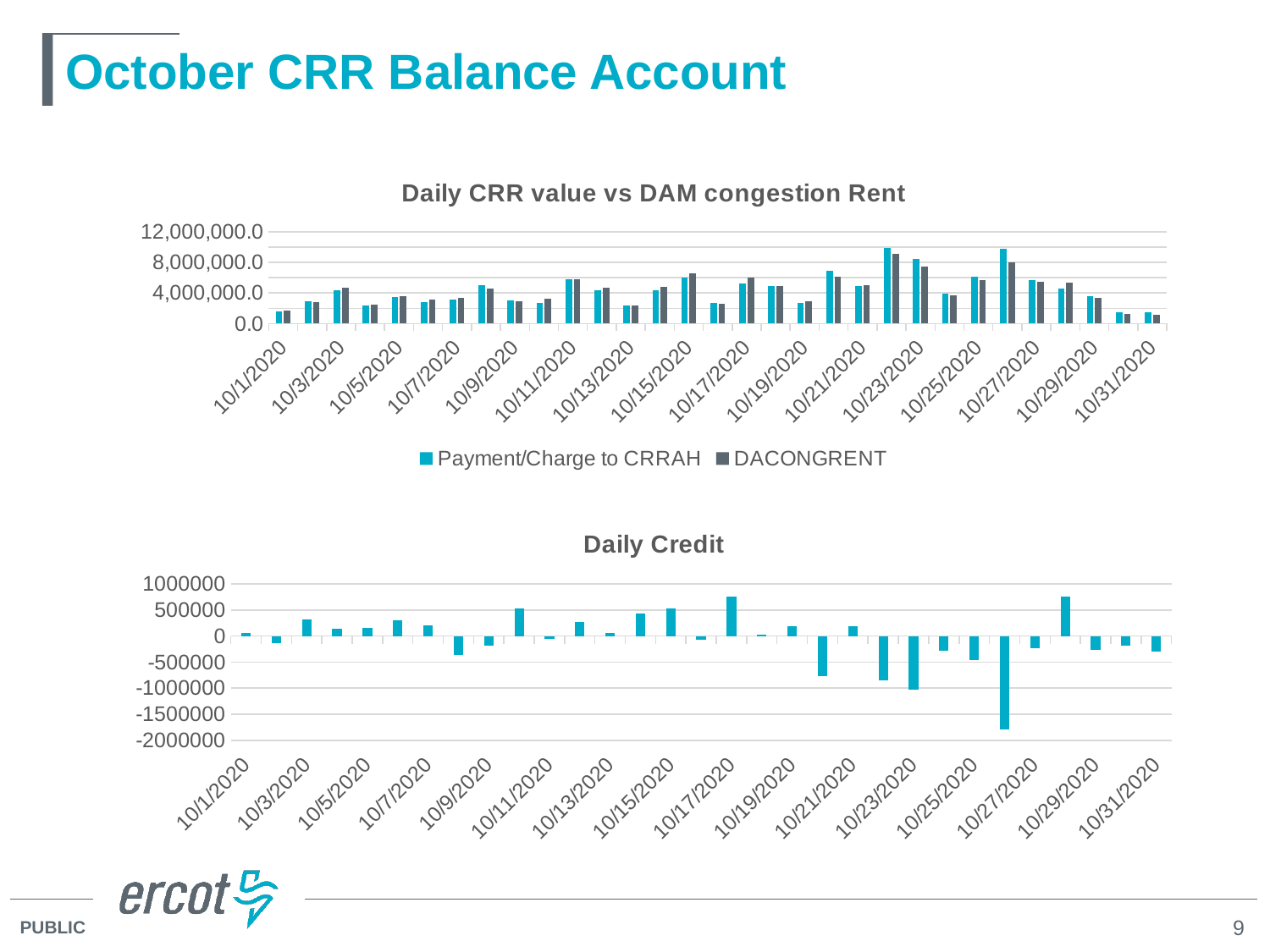
What are the two series named in the legend of the 'Daily CRR value vs DAM congestion Rent' chart? Payment/Charge to CRRAH and DACONGRENT In the 'Daily CRR value vs DAM congestion Rent' chart, is the Payment/Charge to CRRAH value for 10/1/2020 greater or less than 4,000,000.0? less What kind of chart is the 'Daily CRR value vs DAM congestion Rent' chart? bar chart In the 'Daily Credit' chart, is the value for 10/27/2020 greater or less than -1500000? greater How many dates are plotted on the x axis of the 'Daily Credit' chart? 31 In the 'Daily Credit' chart, is the value for 10/17/2020 greater or less than 500000? greater How many series does the legend of the 'Daily CRR value vs DAM congestion Rent' chart list? 2 In the 'Daily Credit' chart, which date has the lowest value? 10/26/2020 In the 'Daily CRR value vs DAM congestion Rent' chart, which date has the larger Payment/Charge to CRRAH value, 10/1/2020 or 10/22/2020? 10/22/2020 In the 'Daily Credit' chart, which date has the larger value, 10/17/2020 or 10/27/2020? 10/17/2020 What kind of chart is the 'Daily Credit' chart? bar chart